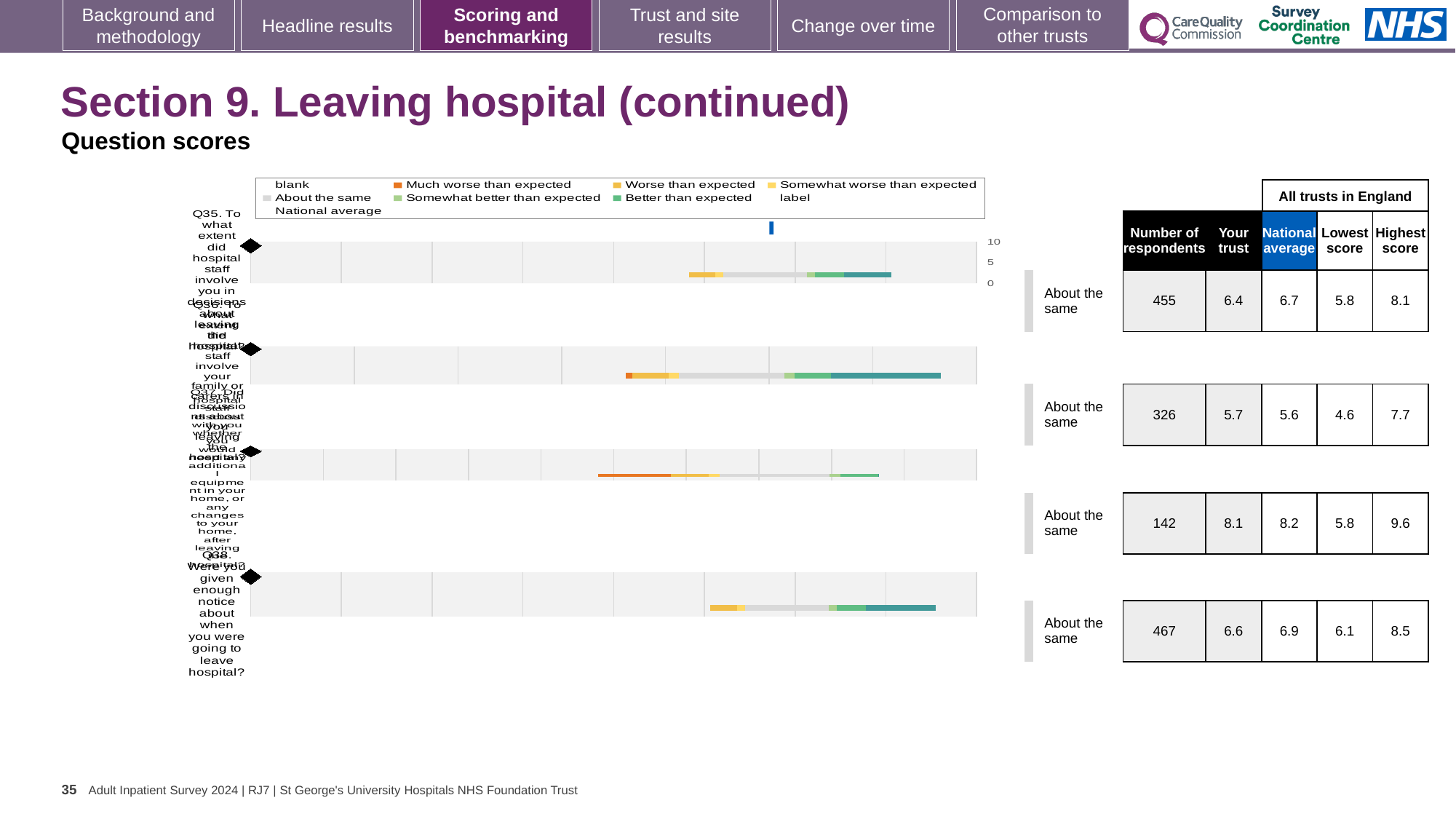
Which row of the table has the fewest respondents? third row (142) In the table, what is the national average for the second row? 5.6 In the table, what is the highest score for the third row? 9.6 What benchmark category label is shown next to each of the four bars? About the same In the table, what is the number of respondents for the first row (Q35)? 455 For the first row (Q35), what is the difference between the national average and the 'Your trust' score? 0.3 What kind of chart is shown on the left of the slide? bar chart Which row of the table has the highest 'Your trust' score? third row (8.1) How many question rows (bars) are plotted in the chart? 4 In the table, what is the lowest score for the last row (Q38)? 6.1 In the table, what is the 'Your trust' score for the first row (Q35)? 6.4 For the last row (Q38), which is larger: the 'Your trust' score or the national average? national average